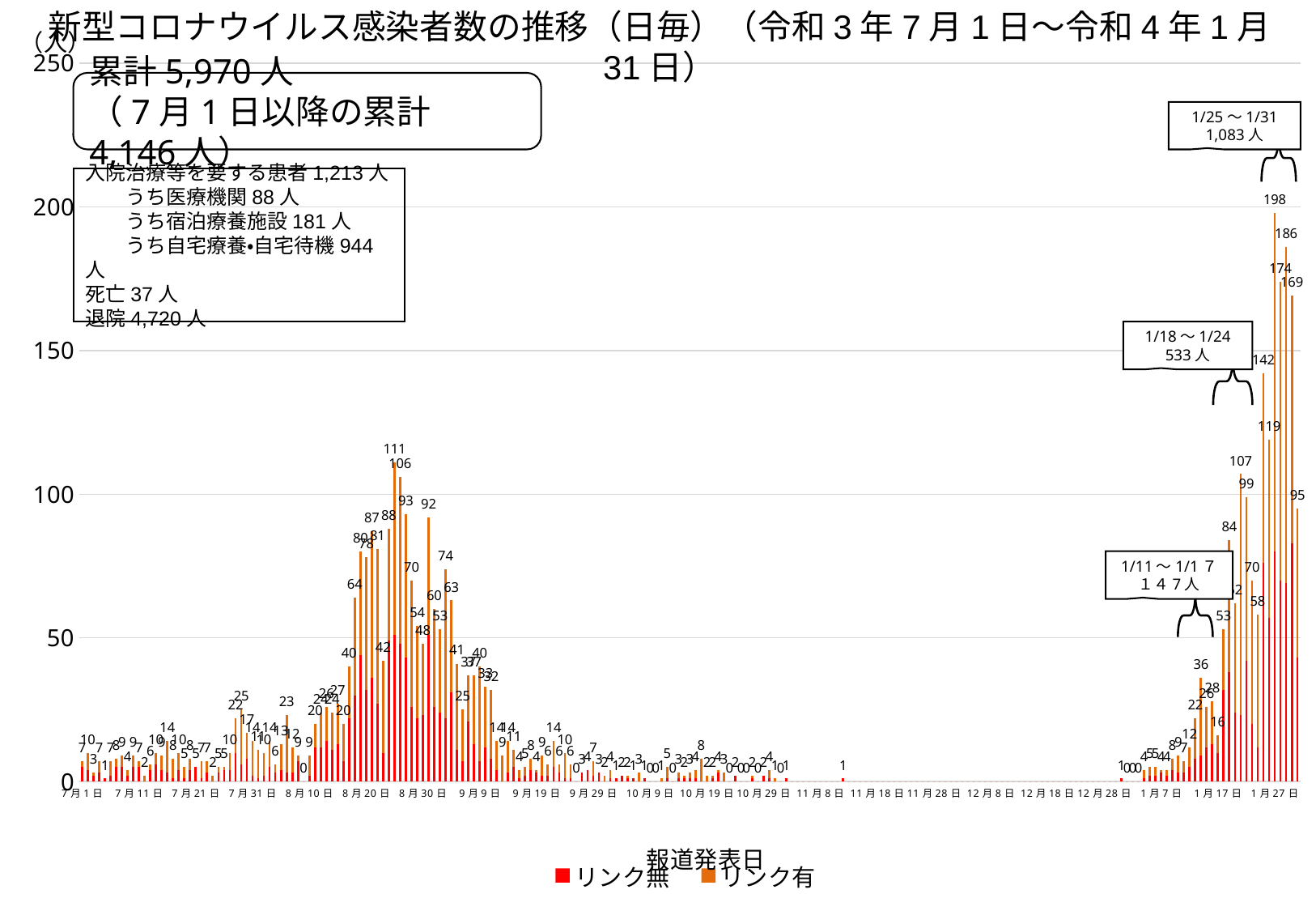
How many series does the legend list? 2 Is the highest bar on the chart greater or less than 150? greater Do the daily values rise or fall from 1/17 toward the end of January? rise Which is larger, the late-January peak or the August peak? the late-January peak (198) What are the two series named in the legend? リンク無 and リンク有 According to the annotation, how many cases were reported from 1/25 to 1/31? 1,083人 What is the title of the x axis? 報道発表日 What is the highest daily value labeled during the August peak? 111 What kind of chart is shown on the slide? bar chart According to the annotation, how many cases were reported from 1/18 to 1/24? 533人 What is the highest daily value labeled on the chart? 198 What is the difference between the overall peak value (198) and the August peak value (111)? 87